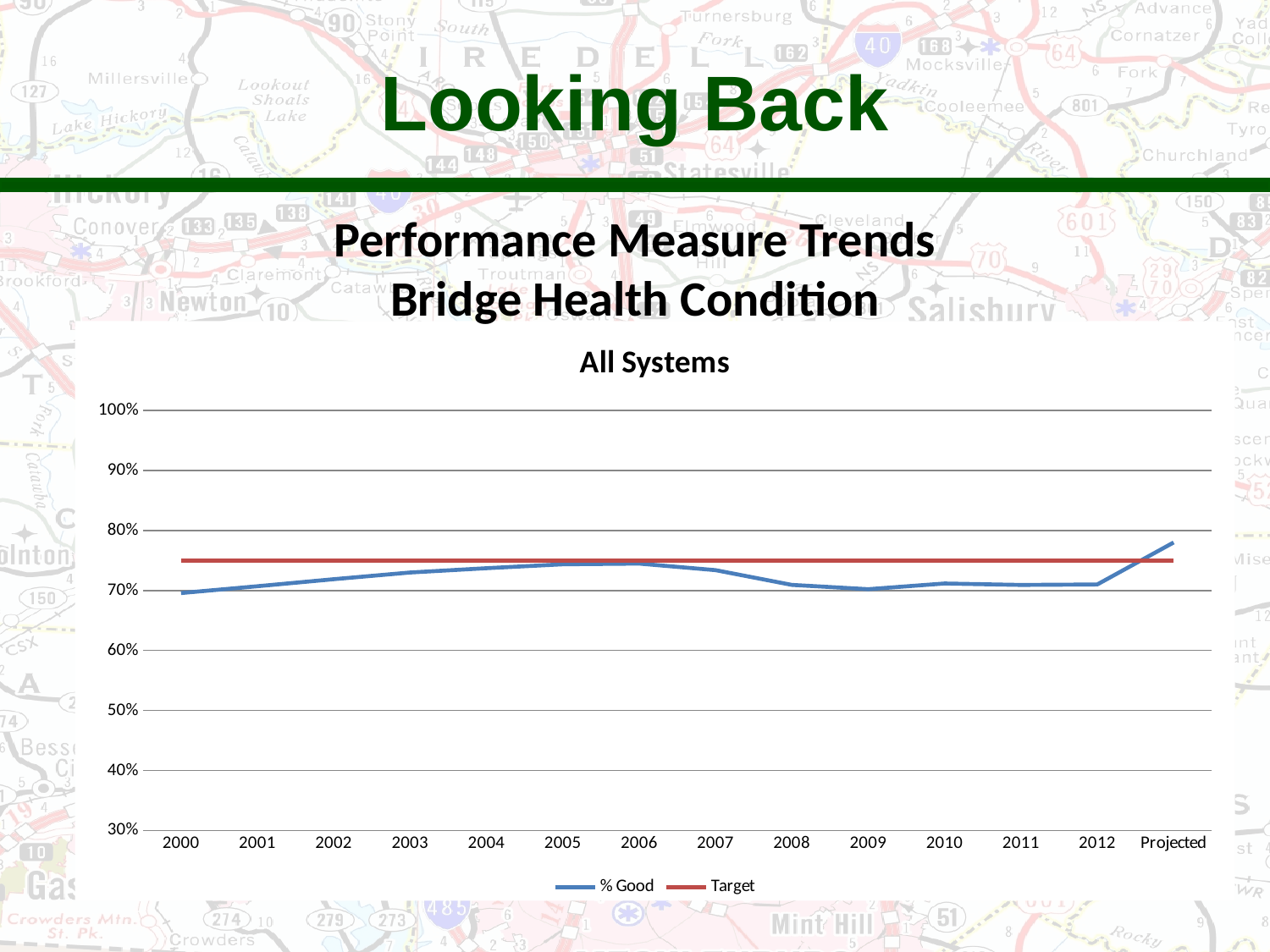
What kind of chart is shown on the slide? line chart Which is larger, the % Good value for 2005 or for 2009? 2005 How many series does the legend list? 2 Does the % Good line rise or fall from 2006 to 2009? fall Is the Target value greater or less than 80%? less Which x-axis point has the highest % Good value? Projected Is the % Good value for 2005 greater or less than 70%? greater What are the two series named in the legend? % Good and Target Is the % Good value for 2012 greater or less than 75%? less How many points are plotted along the x axis? 14 What is the title of the chart? All Systems